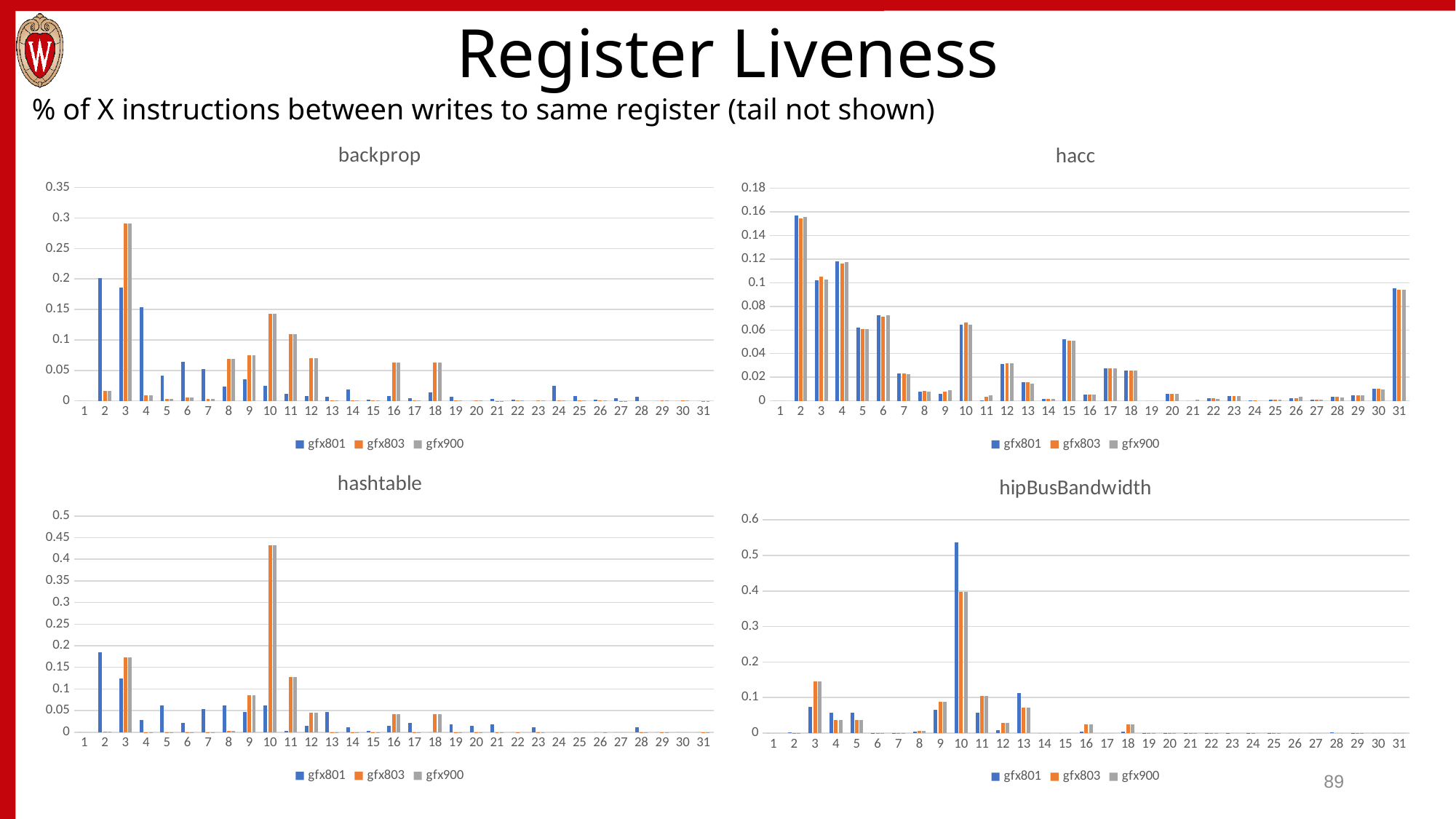
In the hacc chart, which category has the highest gfx801 value? 2 How many categories are shown on the x axis of the hacc chart? 31 How many series does the legend of the backprop chart list? 3 In the hashtable chart, is the gfx801 value for category 2 greater or less than 0.1? greater In the backprop chart, is the gfx801 value for category 2 greater or less than 0.15? greater In the hipBusBandwidth chart, which category has the highest gfx801 value? 10 What kind of chart is the backprop chart? bar chart In the backprop chart, which category has the highest gfx803 value? 3 In the backprop chart, at category 3, which is larger: gfx801 or gfx803? gfx803 In the hacc chart, is the gfx803 value for category 31 greater or less than 0.05? greater In the hipBusBandwidth chart, at category 10, which is larger: gfx801 or gfx803? gfx801